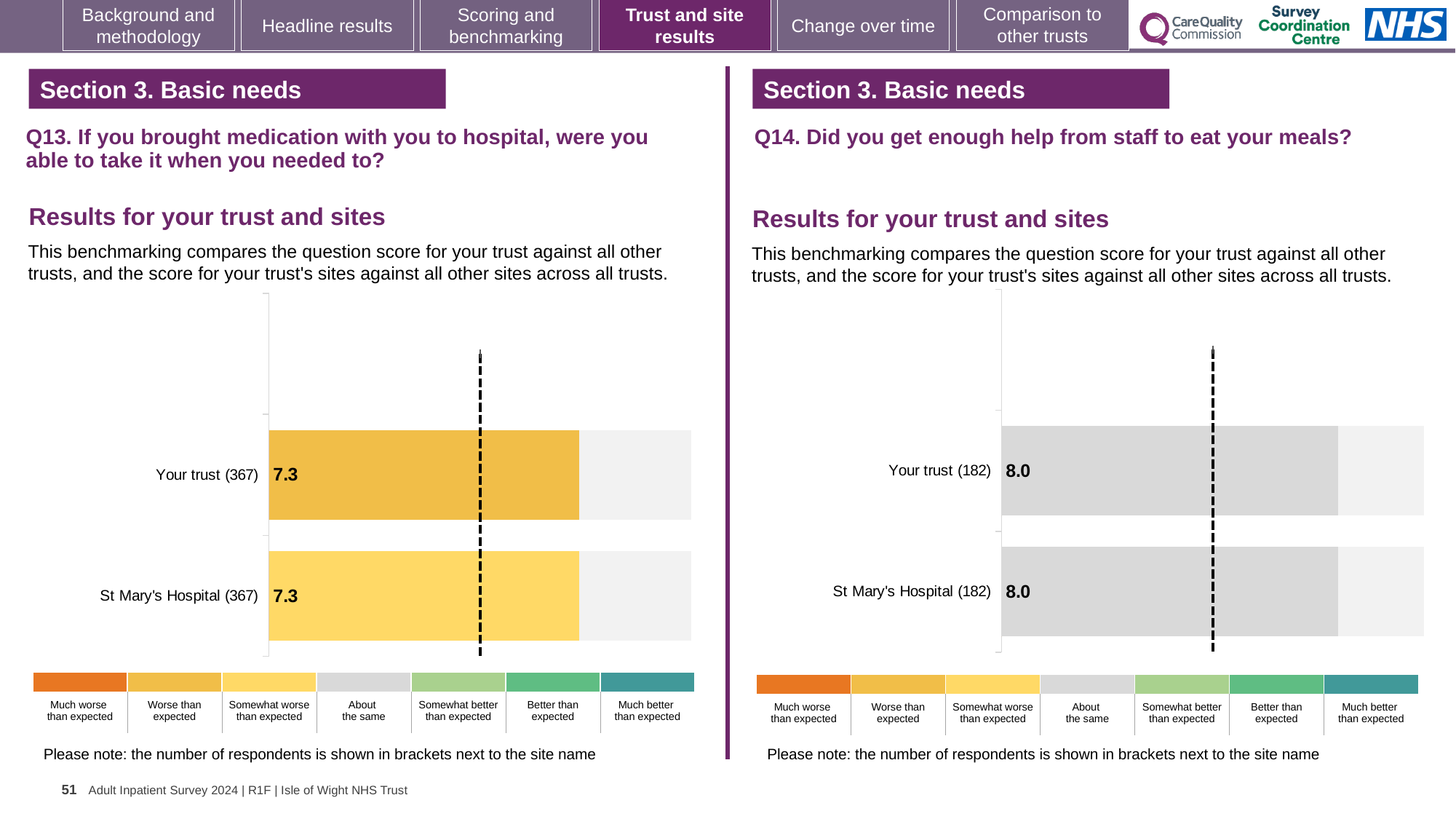
In the Q14 chart on the right, what is the score for Your trust? 8.0 In the Q14 chart on the right, what is the score for St Mary's Hospital? 8.0 In the Q13 chart on the left, what is the score for St Mary's Hospital? 7.3 In the Q13 chart on the left, how many respondents are shown in brackets next to Your trust? 367 How many bars are plotted in the Q14 chart on the right? 2 How many bars are plotted in the Q13 chart on the left? 2 In the Q13 chart on the left, what is the score for Your trust? 7.3 In the Q14 chart on the right, how many respondents are shown in brackets next to St Mary's Hospital? 182 In the Q14 chart on the right, what is the difference between the Your trust score and the St Mary's Hospital score? 0.0 In the Q13 chart on the left, what is the difference between the Your trust score and the St Mary's Hospital score? 0.0 What kind of chart is used for the Q13 results on the left? Bar chart